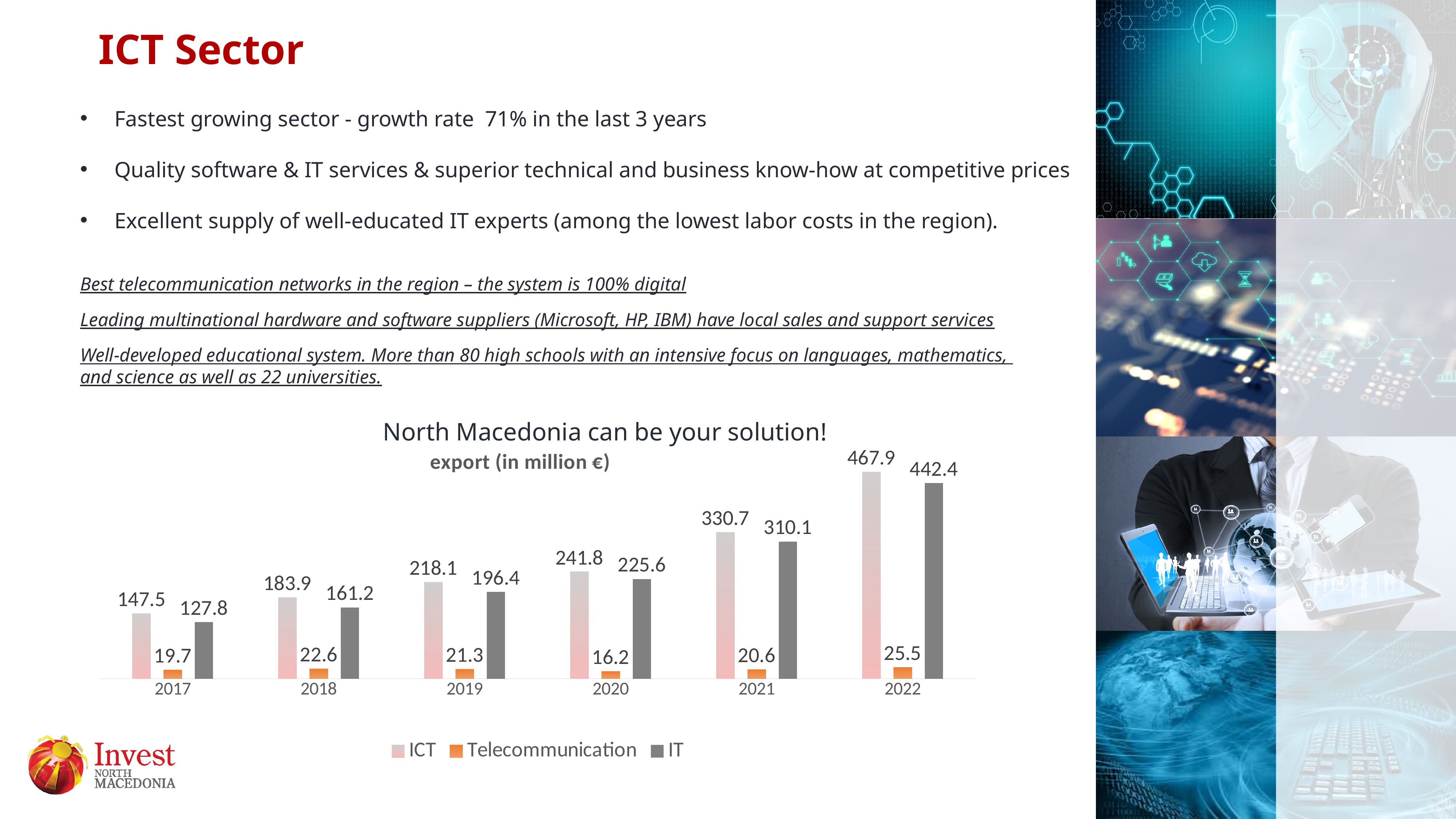
What unit is stated in the chart's subtitle for the export values? million € Which year has the lowest Telecommunication export value? 2020 What is the difference between the ICT and IT export values in 2021? 20.6 Which is larger in 2018, the ICT export value or the IT export value? ICT What is the ICT export value for 2022? 467.9 What kind of chart is shown on the slide? Bar chart How many series does the chart legend list? 3 What is the IT export value for 2019? 196.4 What is the Telecommunication export value for 2020? 16.2 Which year has the highest ICT export value? 2022 How many years are shown on the x axis of the chart? 6 Do the IT export values rise or fall from 2017 to 2022? Rise